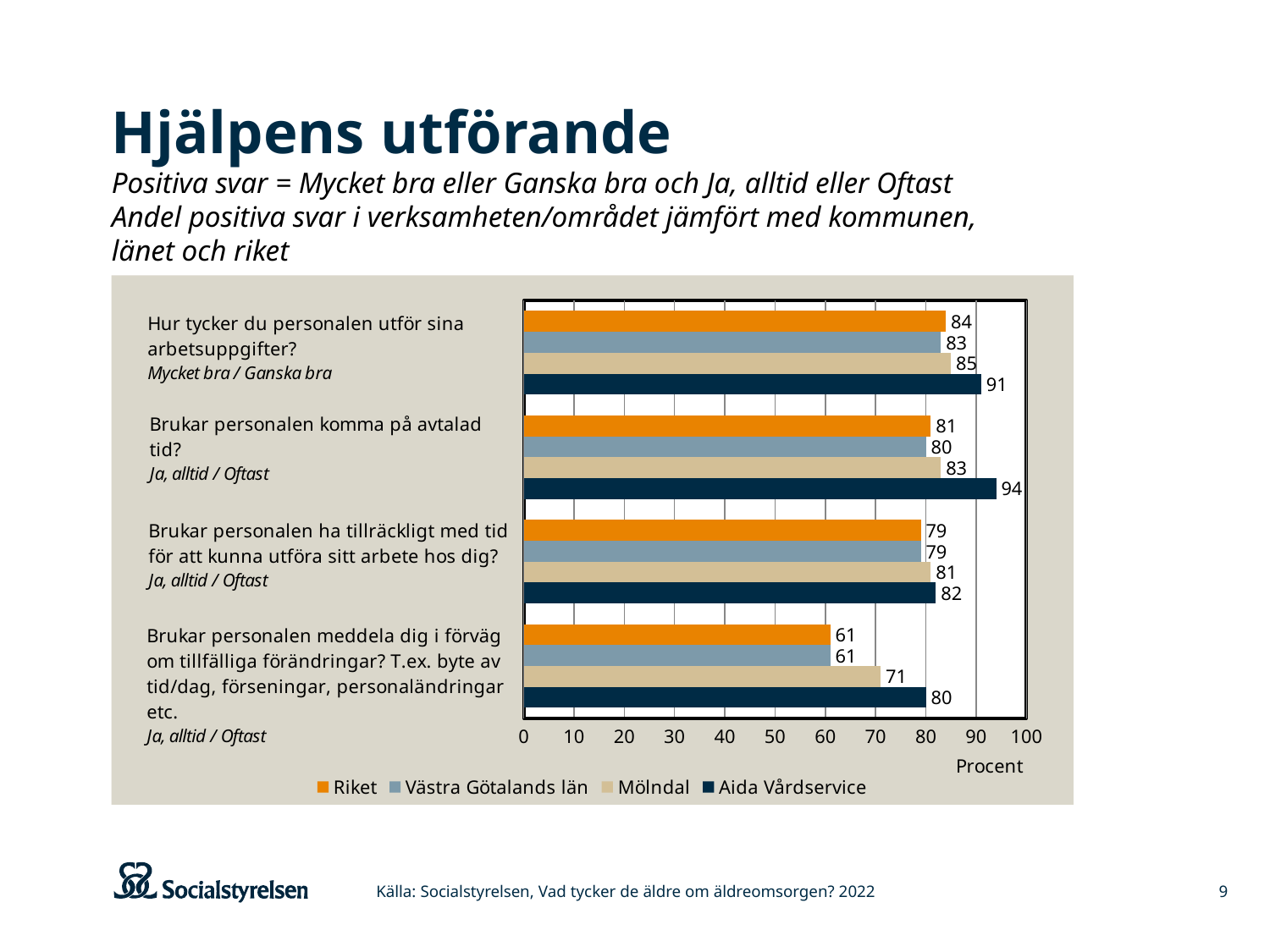
What value is shown for Västra Götalands län on the question 'Brukar personalen ha tillräckligt med tid för att kunna utföra sitt arbete hos dig?' 79 What kind of chart is shown on the slide? Bar chart Which question has the lowest value for Riket? Brukar personalen meddela dig i förväg om tillfälliga förändringar? What value is shown for Riket on the question 'Hur tycker du personalen utför sina arbetsuppgifter?' 84 How many questions (categories) are shown on the chart? 4 How many series does the legend list? 4 What value is shown for Mölndal on the question 'Brukar personalen meddela dig i förväg om tillfälliga förändringar?' 71 Which series has the highest value on the question 'Brukar personalen komma på avtalad tid?' Aida Vårdservice What is the label of the horizontal axis? Procent What is the difference between Aida Vårdservice and Riket on the question 'Brukar personalen meddela dig i förväg om tillfälliga förändringar?' 19 What value is shown for Aida Vårdservice on the question 'Brukar personalen komma på avtalad tid?' 94 Which is larger on the question 'Hur tycker du personalen utför sina arbetsuppgifter?': Mölndal or Västra Götalands län? Mölndal